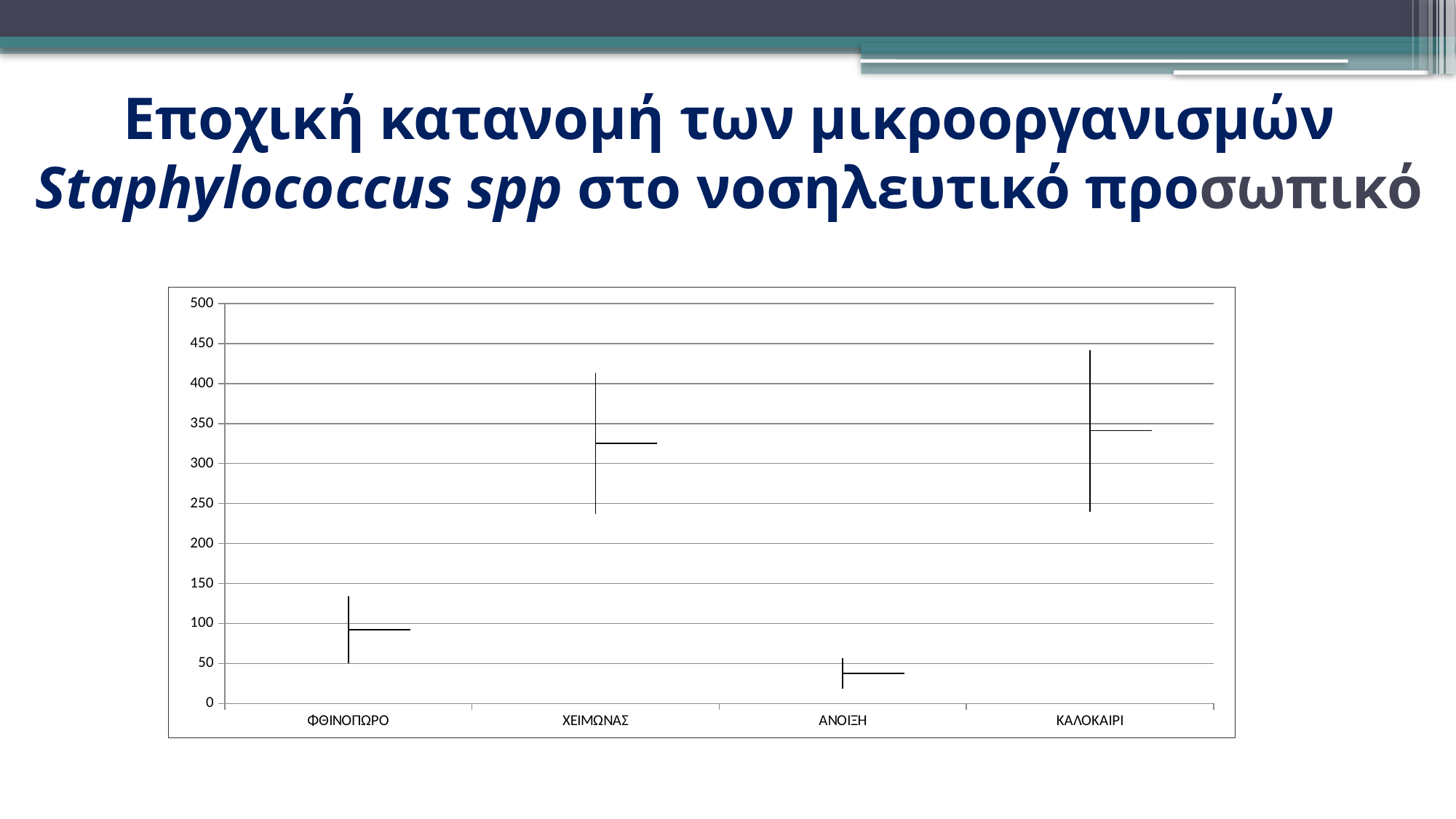
Which category has the lowest marker value in the chart? ΑΝΟΙΞΗ What is the first category label on the x axis of the chart? ΦΘΙΝΟΠΩΡΟ Is the marker value for ΧΕΙΜΩΝΑΣ greater or less than 300? greater How many categories are shown on the x axis of the chart? 4 Which category's vertical range reaches the highest point on the chart? ΚΑΛΟΚΑΙΡΙ Which has the larger marker value, ΦΘΙΝΟΠΩΡΟ or ΧΕΙΜΩΝΑΣ? ΧΕΙΜΩΝΑΣ What kind of chart is shown on the slide? high-low-close (stock) chart Which has the larger marker value, ΑΝΟΙΞΗ or ΚΑΛΟΚΑΙΡΙ? ΚΑΛΟΚΑΙΡΙ What is the maximum value shown on the y axis of the chart? 500 Is the marker value for ΦΘΙΝΟΠΩΡΟ greater or less than 100? less Is the marker value for ΚΑΛΟΚΑΙΡΙ greater or less than 300? greater